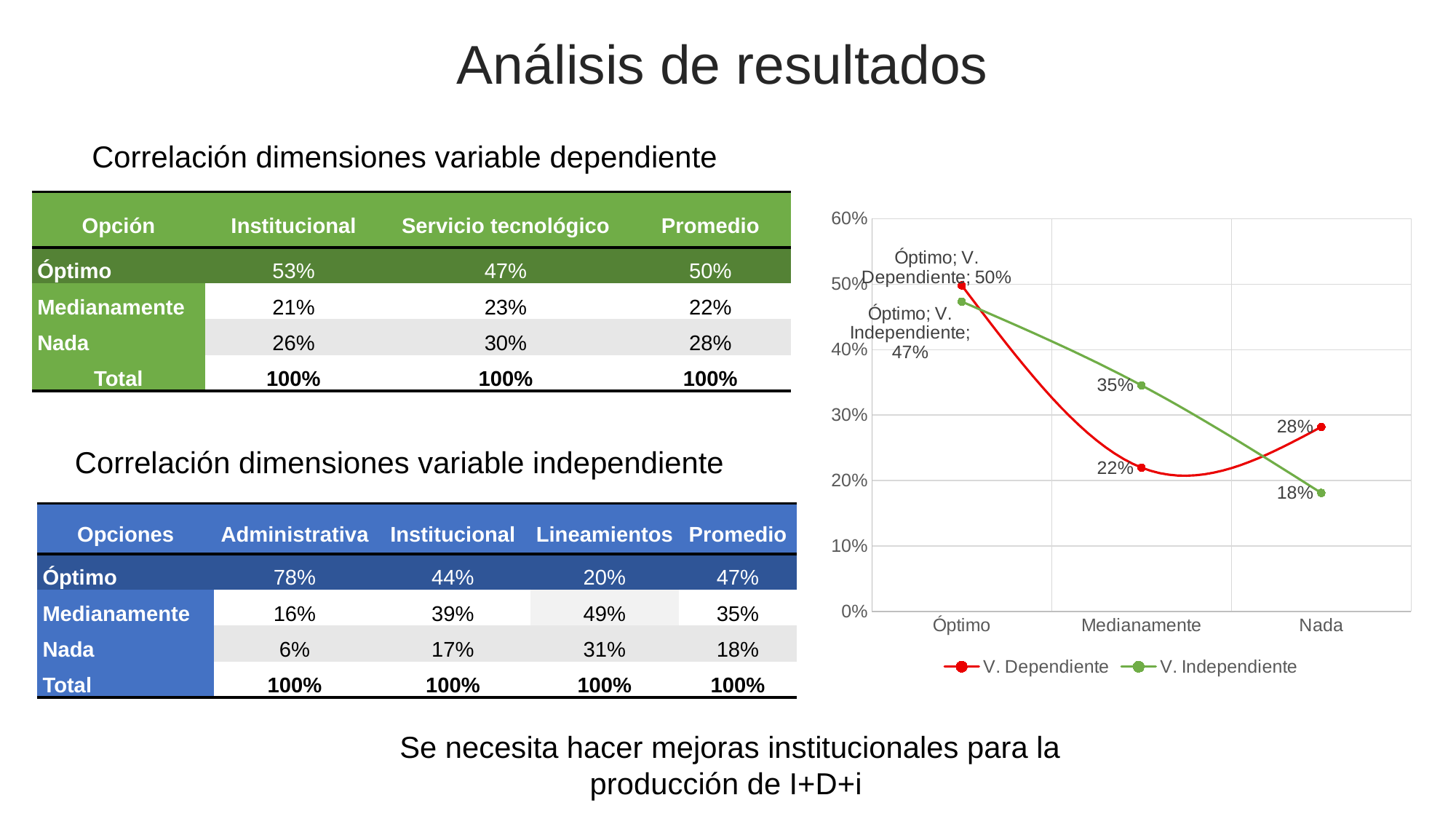
What is the value of V. Independiente for Medianamente in the chart? 35% How many series does the chart legend list? 2 What is the value of V. Dependiente for Óptimo in the chart? 50% What is the difference between V. Dependiente and V. Independiente for Nada in the chart? 10% What kind of chart is shown on the slide? line chart Which colour is used for the V. Independiente line in the chart? green For Medianamente, which series has the larger value in the chart, V. Dependiente or V. Independiente? V. Independiente How many categories are shown on the x axis of the chart? 3 Which category has the lowest value for V. Dependiente in the chart? Medianamente Which category has the highest value for V. Independiente in the chart? Óptimo What is the value of V. Dependiente for Nada in the chart? 28% What is the value of V. Independiente for Nada in the chart? 18%